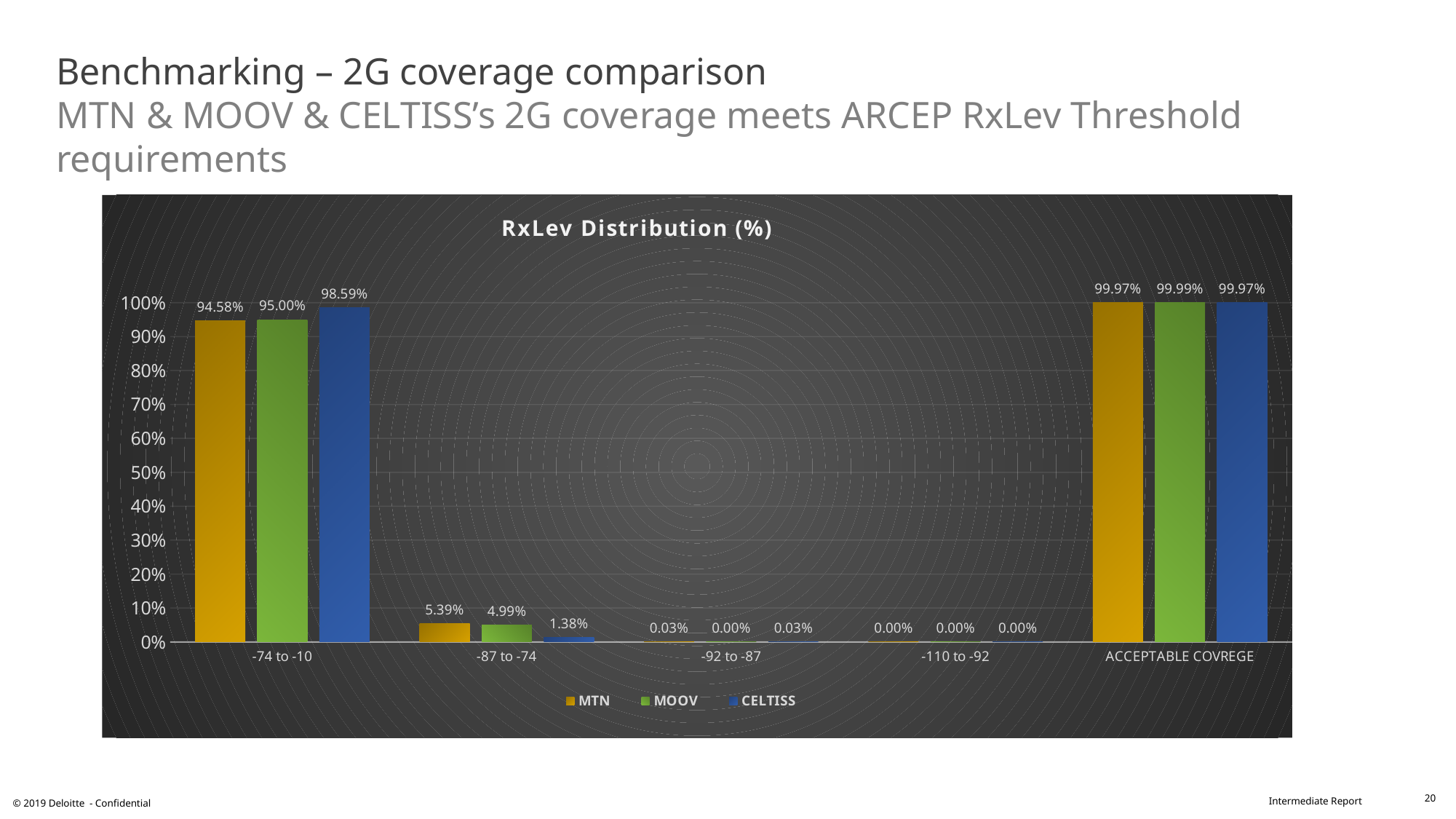
What is the value for MTN in the -87 to -74 category? 5.39% Which is larger in the -87 to -74 category, MTN or MOOV? MTN How many categories are shown on the x axis? 5 What is the value for CELTISS in the -74 to -10 category? 98.59% What type of chart is shown on the slide? Bar chart What is the difference between MOOV and MTN in the -74 to -10 category? 0.42% How many series does the legend list? 3 Which operator has the highest value in the -74 to -10 category? CELTISS What is the value for MOOV in the ACCEPTABLE COVREGE category? 99.99% Which operator has the lowest value in the -87 to -74 category? CELTISS What is the value for MOOV in the -92 to -87 category? 0.00% What is the title of the chart? RxLev Distribution (%)